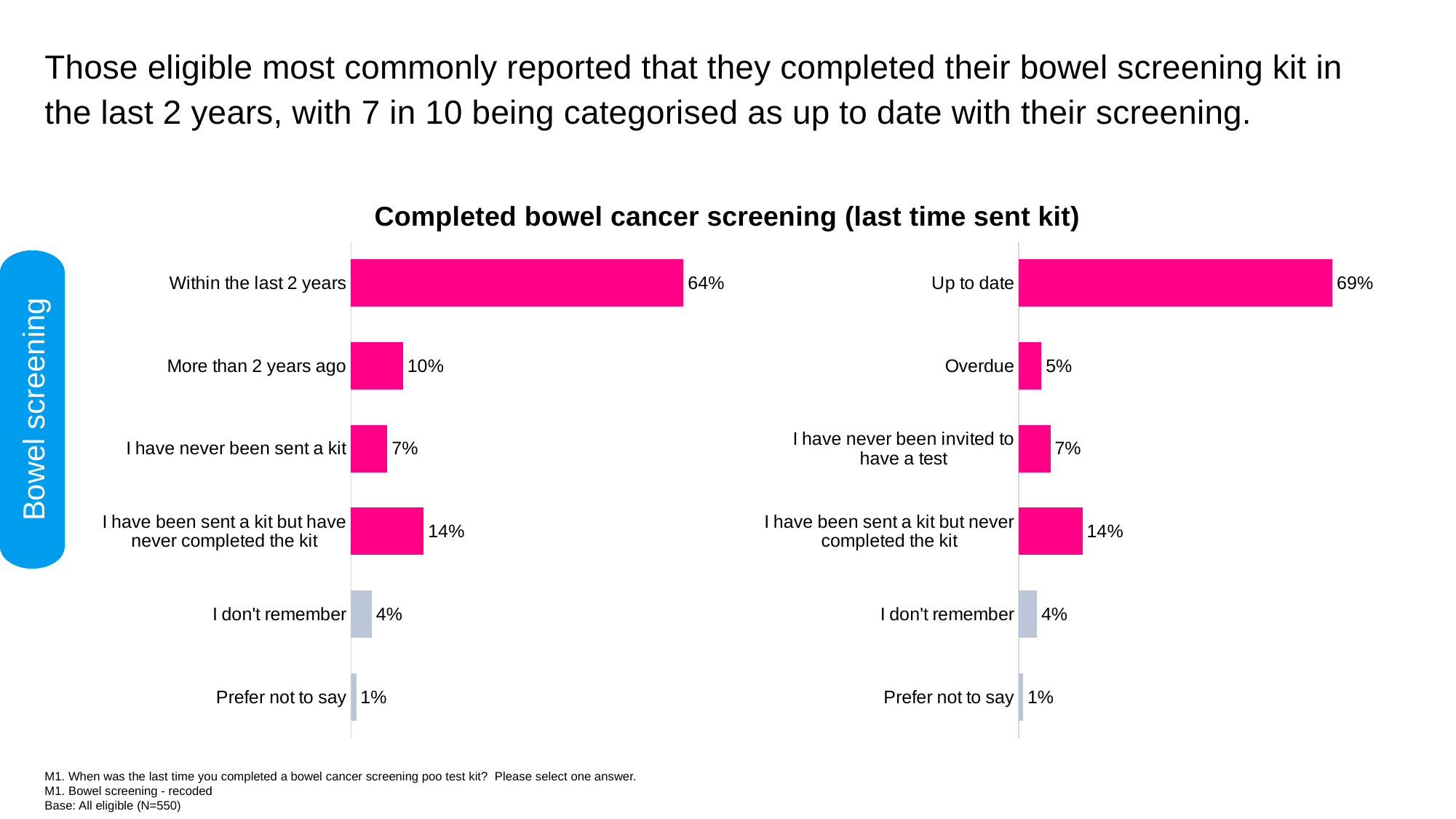
In the left chart, which category has the lowest value? Prefer not to say How many categories are shown in the right chart? 6 In the left chart, what is the value for 'More than 2 years ago'? 10% In the right chart, what is the difference between 'Up to date' and 'Overdue'? 64% In the left chart, which is larger: 'More than 2 years ago' or 'I have never been sent a kit'? More than 2 years ago In the right chart, which category has the highest value? Up to date In the right chart, what percentage are categorised as up to date? 69% What is the title shown above the charts? Completed bowel cancer screening (last time sent kit) What type of chart is the left chart? Bar chart In the right chart, what is the value for 'Overdue'? 5% In the left chart, what percentage reported completing their kit within the last 2 years? 64% In the left chart, what is the difference between 'Within the last 2 years' and 'I have been sent a kit but have never completed the kit'? 50%